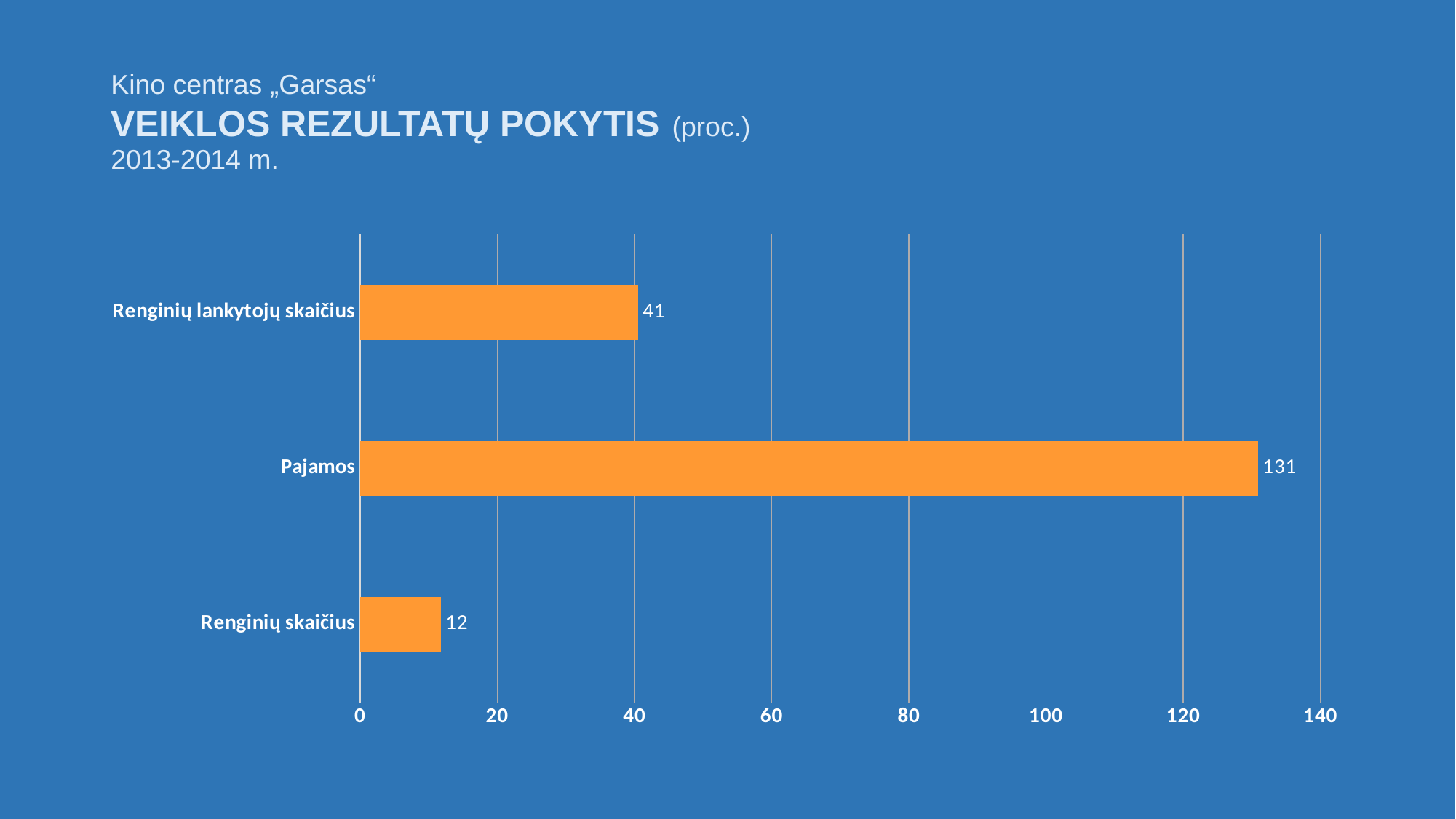
What is the value for Renginių lankytojų skaičius? 41 Is the value for Pajamos greater or less than 120? greater Which category has the highest value? Pajamos How many categories are shown in the chart? 3 What is the highest tick value shown on the horizontal axis? 140 What is the value for Pajamos? 131 What is the value for Renginių skaičius? 12 What kind of chart is shown on the slide? bar chart What is the difference between the values for Renginių lankytojų skaičius and Renginių skaičius? 29 What is the difference between the values for Pajamos and Renginių lankytojų skaičius? 90 Which category has the lowest value? Renginių skaičius Which is larger, the value for Renginių lankytojų skaičius or the value for Renginių skaičius? Renginių lankytojų skaičius